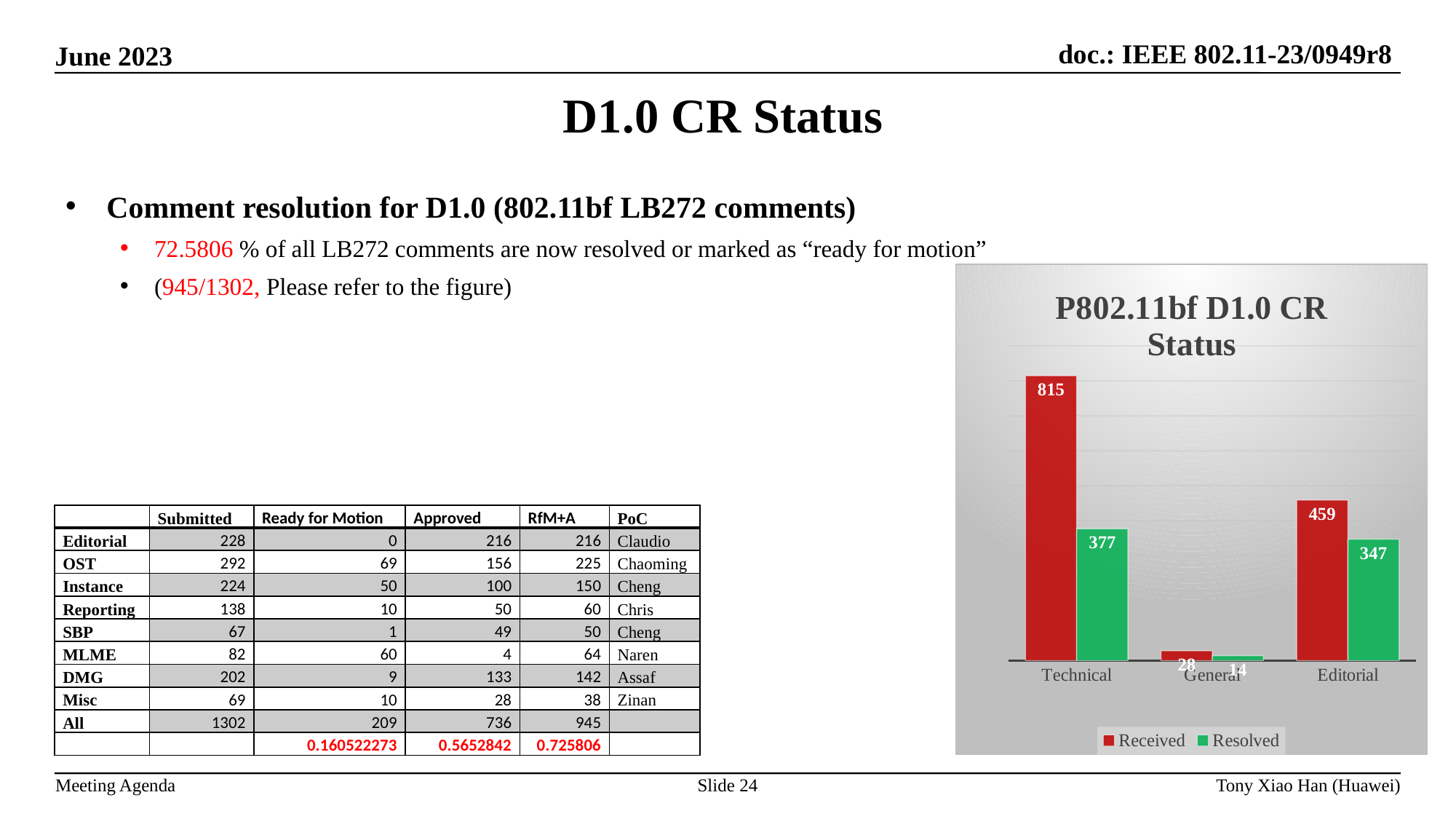
What is the difference between Received and Resolved for Technical? 438 How many series does the chart legend list? 2 How many categories are shown on the x axis of the chart? 3 What is the title of the chart? P802.11bf D1.0 CR Status Which category has the lowest Resolved value? General Which is larger, the Resolved value for Editorial or the Resolved value for Technical? Resolved value for Technical What type of chart is shown on the slide? bar chart What is the Received value for General? 28 What is the Received value for Technical? 815 Which series is shown in red in the chart? Received Which category has the highest Received value? Technical What is the Resolved value for Editorial? 347